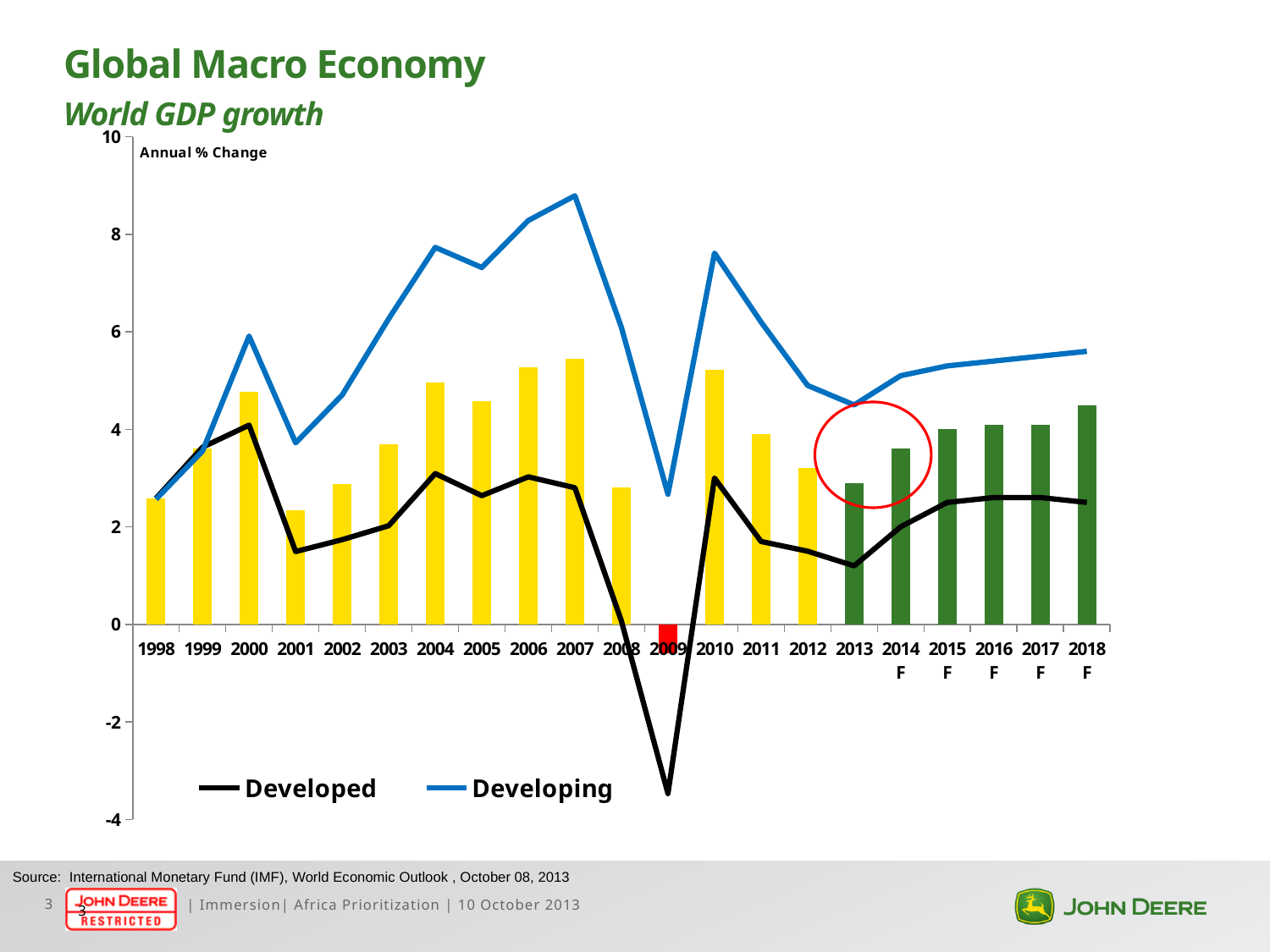
Is the Developing value for 2007 greater or less than 8? greater Which year has the lowest bar? 2009 In which year does the Developed line reach its highest value? 2000 Which is larger in 2007, the Developing value or the Developed value? Developing What kind of chart is shown on the slide? A combined bar and line chart Does the Developing line rise or fall from 2013 to 2018 F? Rise In which year does the Developed line reach its lowest value? 2009 How many years are shown along the x axis? 21 Is the bar value for 2018 F greater or less than 4? greater In which year does the Developing line reach its highest value? 2007 How many series does the legend list? 2 Is the Developed value for 2009 greater or less than -2? less